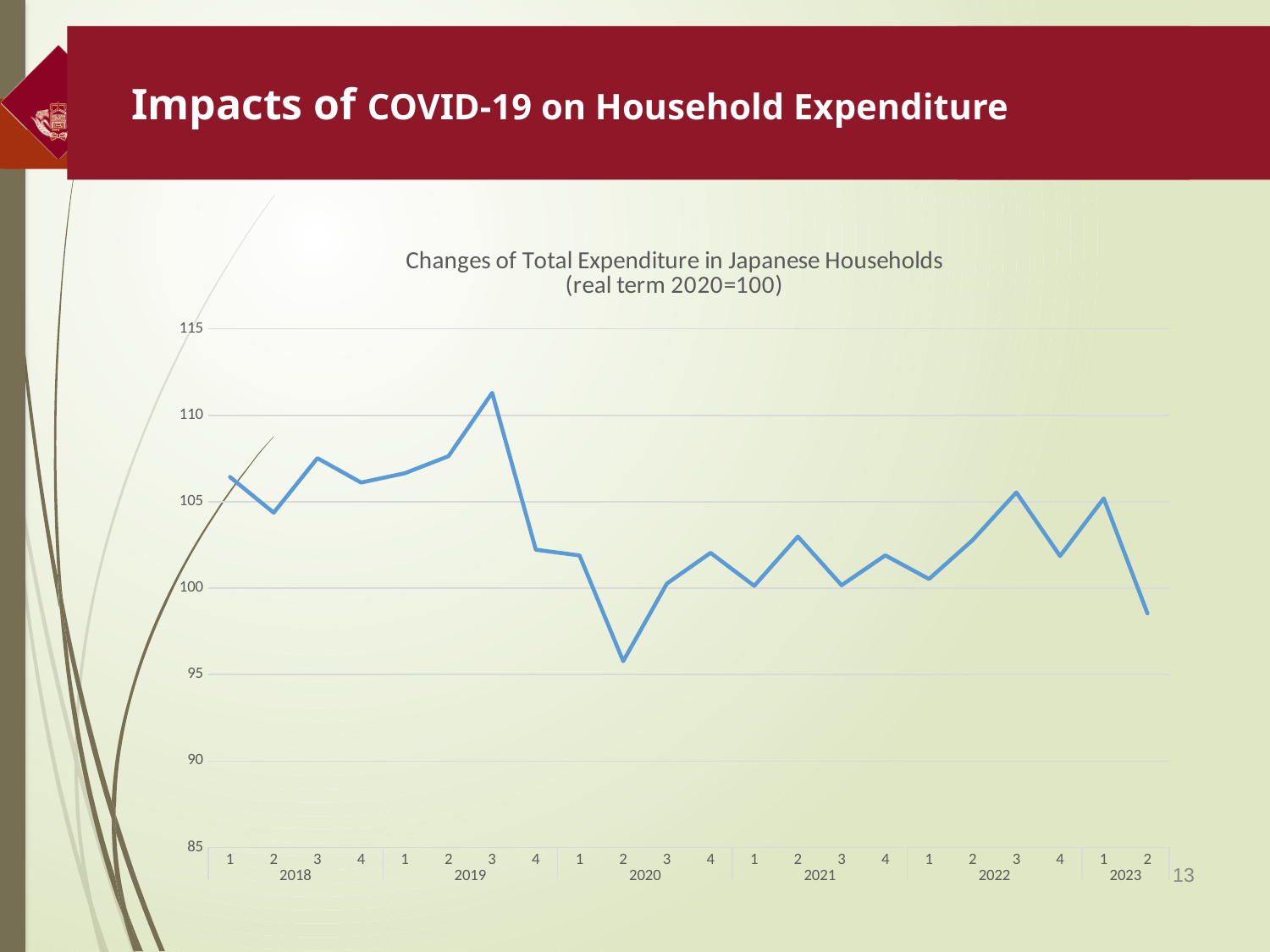
What kind of chart is shown on the slide? Line chart In which quarter does the line reach its lowest value? Quarter 2 of 2020 Is the value for quarter 3 of 2022 greater or less than 105? greater What is the title of the chart? Changes of Total Expenditure in Japanese Households (real term 2020=100) What is the lowest value shown on the vertical axis? 85 In which quarter does the line reach its highest value? Quarter 3 of 2019 Does the line rise or fall between quarter 3 of 2019 and quarter 2 of 2020? Fall Is the value for quarter 2 of 2023 greater or less than 100? less Which is larger, the value for quarter 1 of 2018 or the value for quarter 2 of 2020? Quarter 1 of 2018 Is the value for quarter 3 of 2019 greater or less than 110? greater How many quarterly data points are plotted on the chart? 22